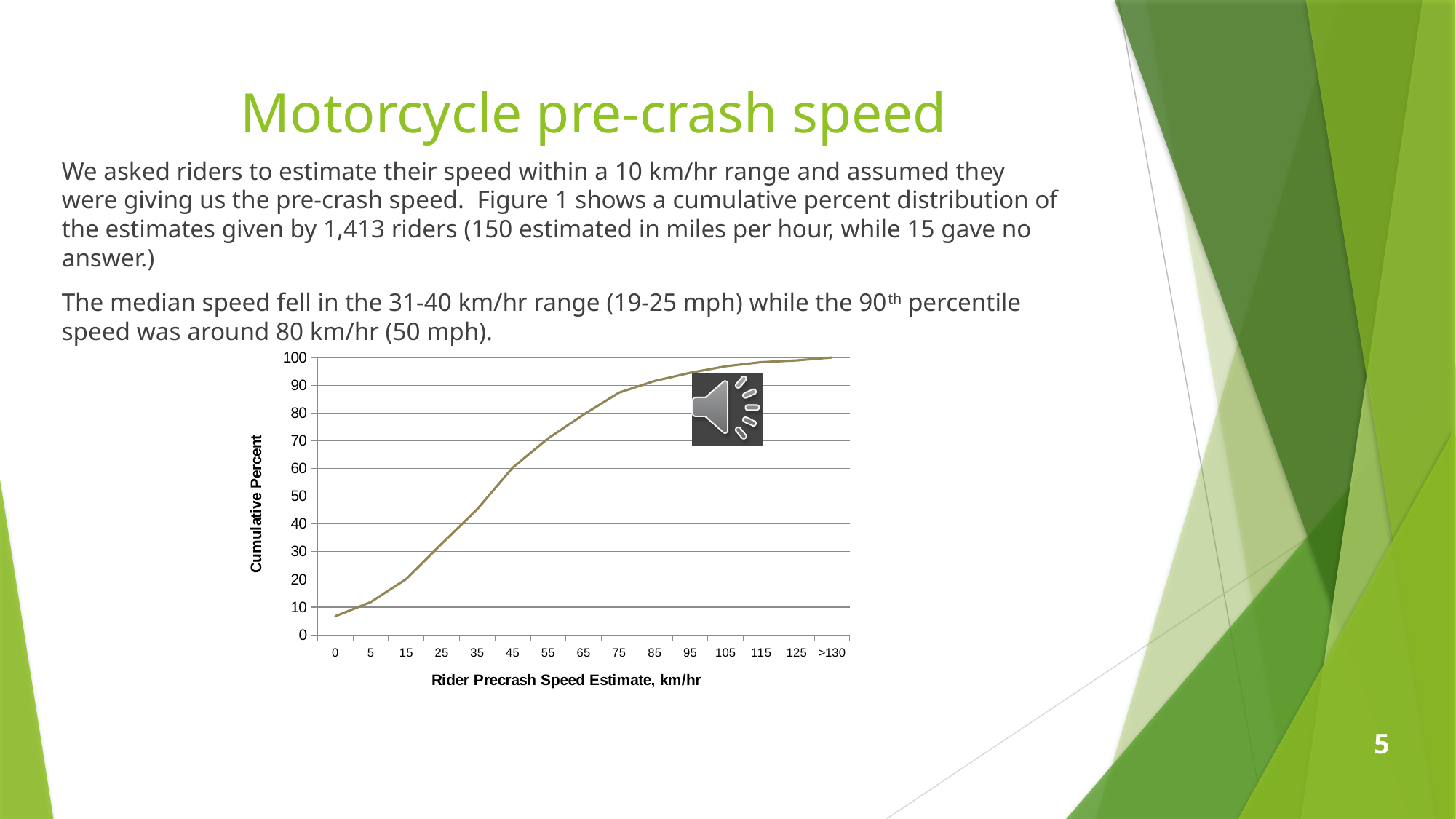
Is the cumulative percent at a speed estimate of 25 km/hr greater or less than 40? less Is the cumulative percent at a speed estimate of 75 km/hr greater or less than 80? greater Is the cumulative percent at a speed estimate of 105 km/hr greater or less than 90? greater What kind of chart is shown on the slide? line chart Which speed estimate category has the lowest cumulative percent? 0 Which speed estimate category has the highest cumulative percent? >130 What is the title of the x axis of the chart? Rider Precrash Speed Estimate, km/hr Does the cumulative percent rise or fall as the rider precrash speed estimate increases? rise How many speed estimate categories are labelled on the x axis? 15